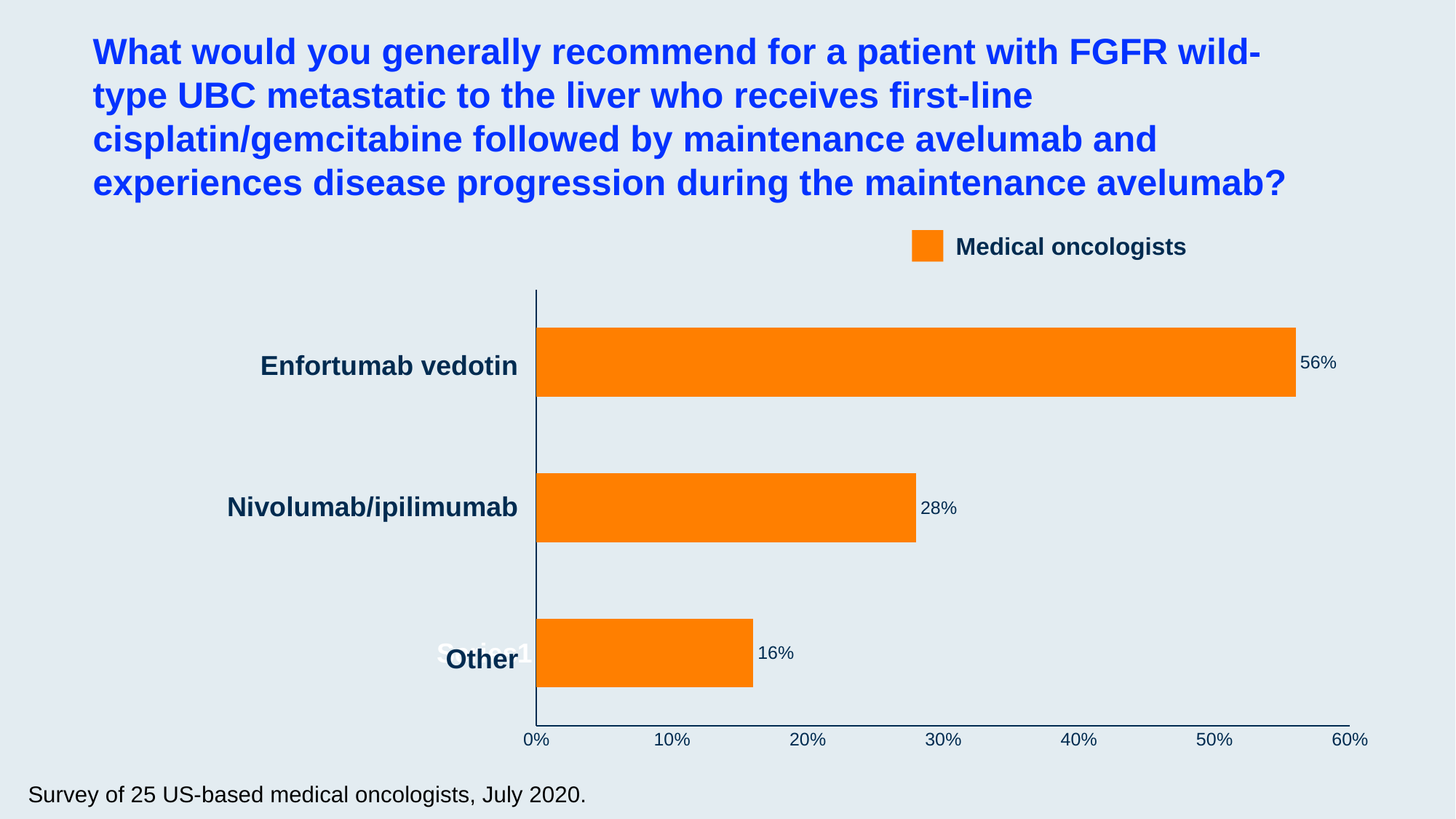
What percentage of medical oncologists recommend Enfortumab vedotin? 56% How many series does the legend list? 1 Which option has the lowest percentage of recommendations? Other What percentage of medical oncologists recommend Nivolumab/ipilimumab? 28% Which option has the highest percentage of recommendations? Enfortumab vedotin What percentage of medical oncologists chose Other? 16% What is the difference in percentage points between Enfortumab vedotin and Nivolumab/ipilimumab? 28 percentage points Which is larger, the value for Nivolumab/ipilimumab or the value for Other? Nivolumab/ipilimumab Is the value for Enfortumab vedotin greater or less than 50%? greater What is the difference in percentage points between Nivolumab/ipilimumab and Other? 12 percentage points What kind of chart is shown on the slide? Bar chart How many response options are shown in the chart? 3